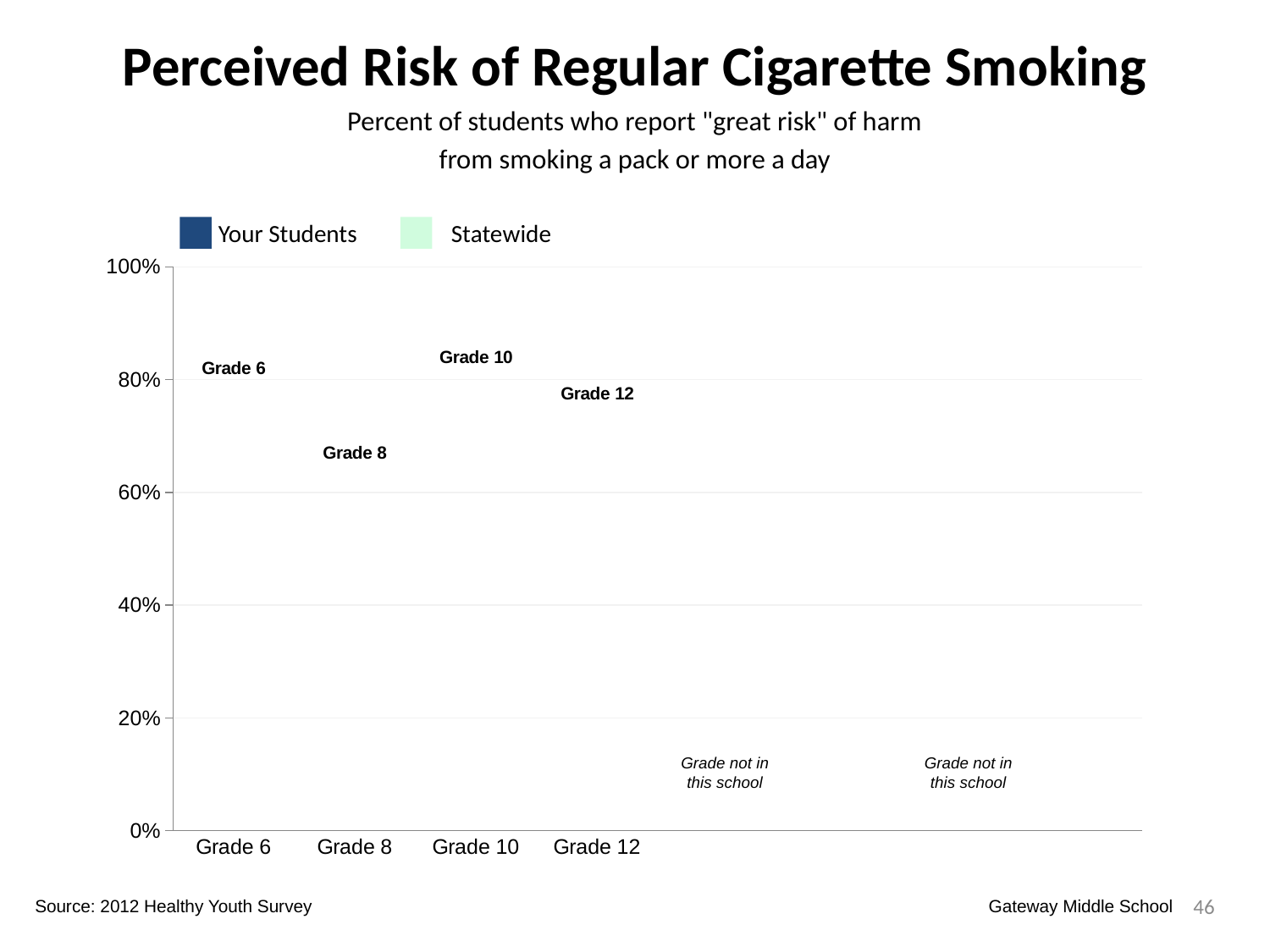
What is the highest value shown on the chart's y axis? 100% What are the two series named in the chart's legend? Your Students and Statewide How many grade categories are shown on the x axis of the chart? 4 How many series does the chart's legend list? 2 What is the title of the chart on the slide? Perceived Risk of Regular Cigarette Smoking